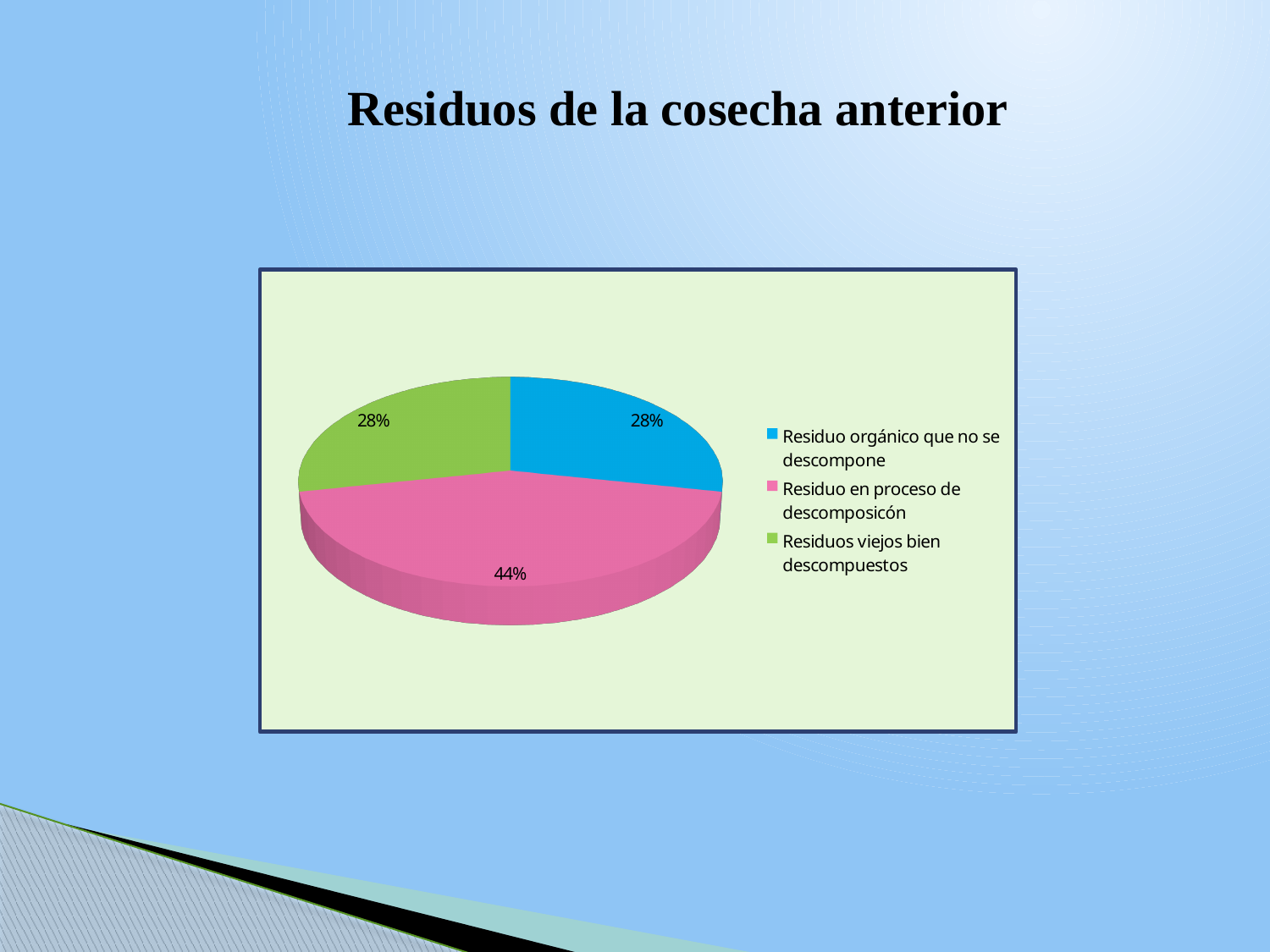
What is the title shown above the chart? Residuos de la cosecha anterior How many entries does the legend list? 3 What kind of chart is shown on the slide? pie chart What share of the pie is 'Residuos viejos bien descompuestos'? 28% What colour is the slice for 'Residuo en proceso de descomposicón'? pink Which category has the largest slice of the pie? Residuo en proceso de descomposicón What share of the pie is 'Residuo orgánico que no se descompone'? 28% How many slices does the pie chart have? 3 Which is larger: the share for 'Residuo en proceso de descomposicón' or the share for 'Residuo orgánico que no se descompone'? Residuo en proceso de descomposicón What share of the pie is 'Residuo en proceso de descomposicón'? 44% What is the difference between the share for 'Residuo en proceso de descomposicón' and the share for 'Residuos viejos bien descompuestos'? 16%